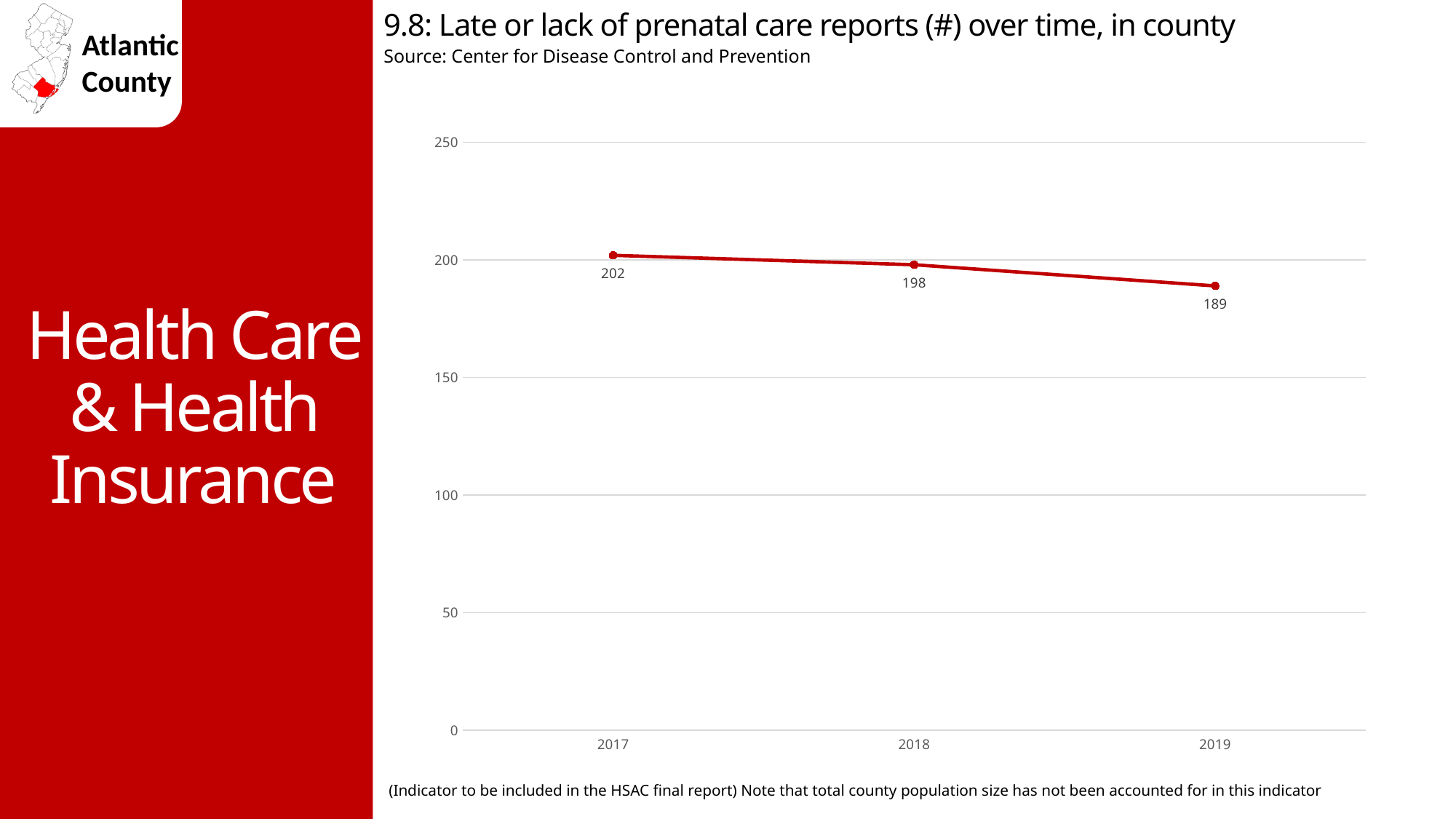
How many years are plotted on the chart? 3 What is the number of late or lack of prenatal care reports in 2018? 198 Which year has the highest number of late or lack of prenatal care reports? 2017 Which year has the lowest number of late or lack of prenatal care reports? 2019 Which year has more late or lack of prenatal care reports, 2017 or 2018? 2017 What is the number of late or lack of prenatal care reports in 2019? 189 What is the number of late or lack of prenatal care reports in 2017? 202 What is the difference between the number of reports in 2017 and 2019? 13 Do the values rise or fall from 2017 to 2019? fall What is the difference between the number of reports in 2018 and 2019? 9 What kind of chart is shown on the slide? line chart Is the value for 2019 greater or less than 200? less